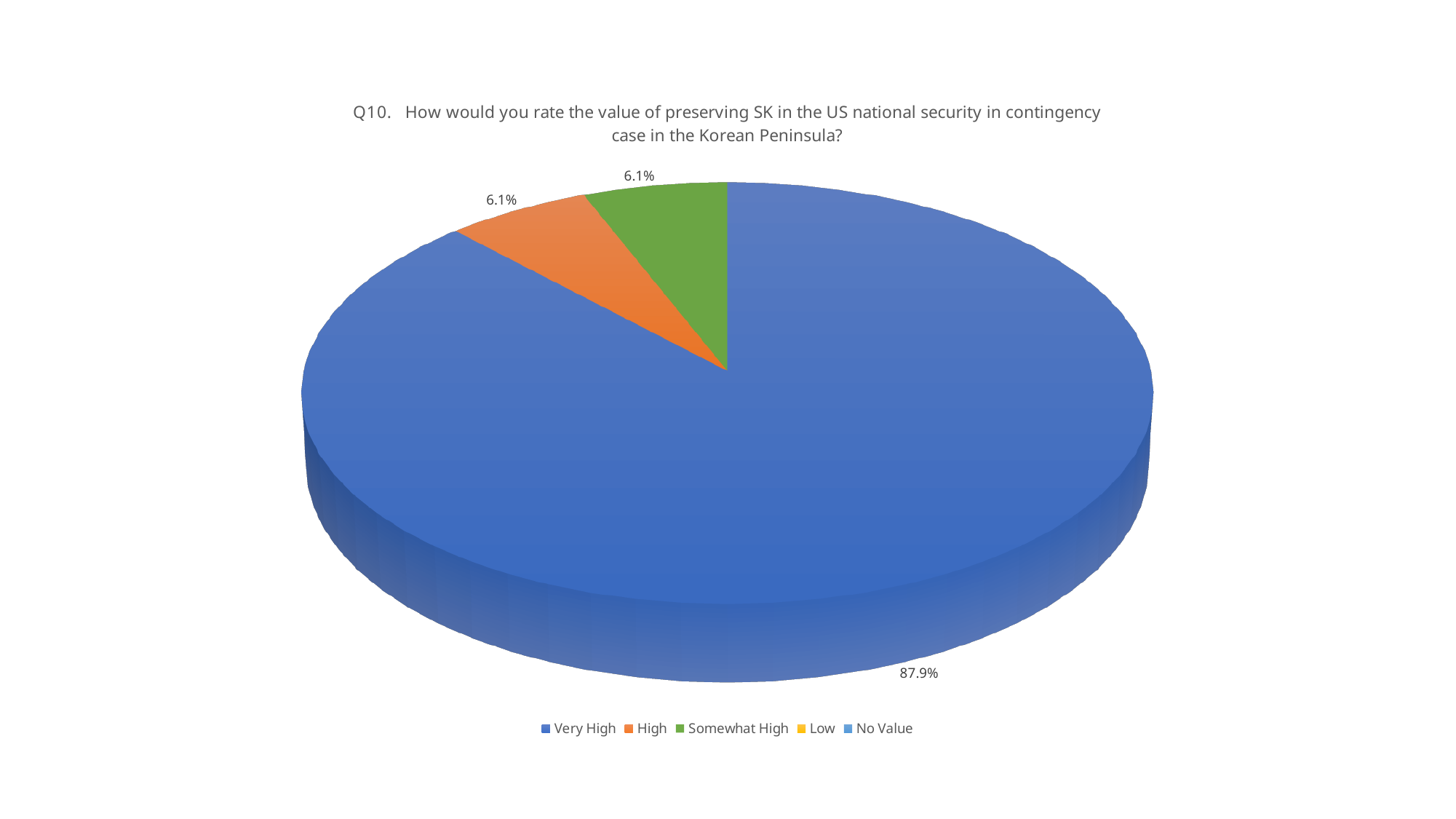
What is the combined share of the High and Somewhat High slices? 12.2% How many slices are visible in the pie? 3 How many categories does the legend list? 5 Which category has the largest slice of the pie? Very High Which legend entries have no visible slice in the pie? Low and No Value Which is larger, the Very High slice or the Somewhat High slice? Very High What percentage is shown for the High slice? 6.1% What percentage is shown for the Somewhat High slice? 6.1% What is the difference in percentage points between the Very High slice and the High slice? 81.8 What share of the pie does the Very High slice represent? 87.9% What colour is the Very High slice? Blue What kind of chart is shown on the slide? Pie chart